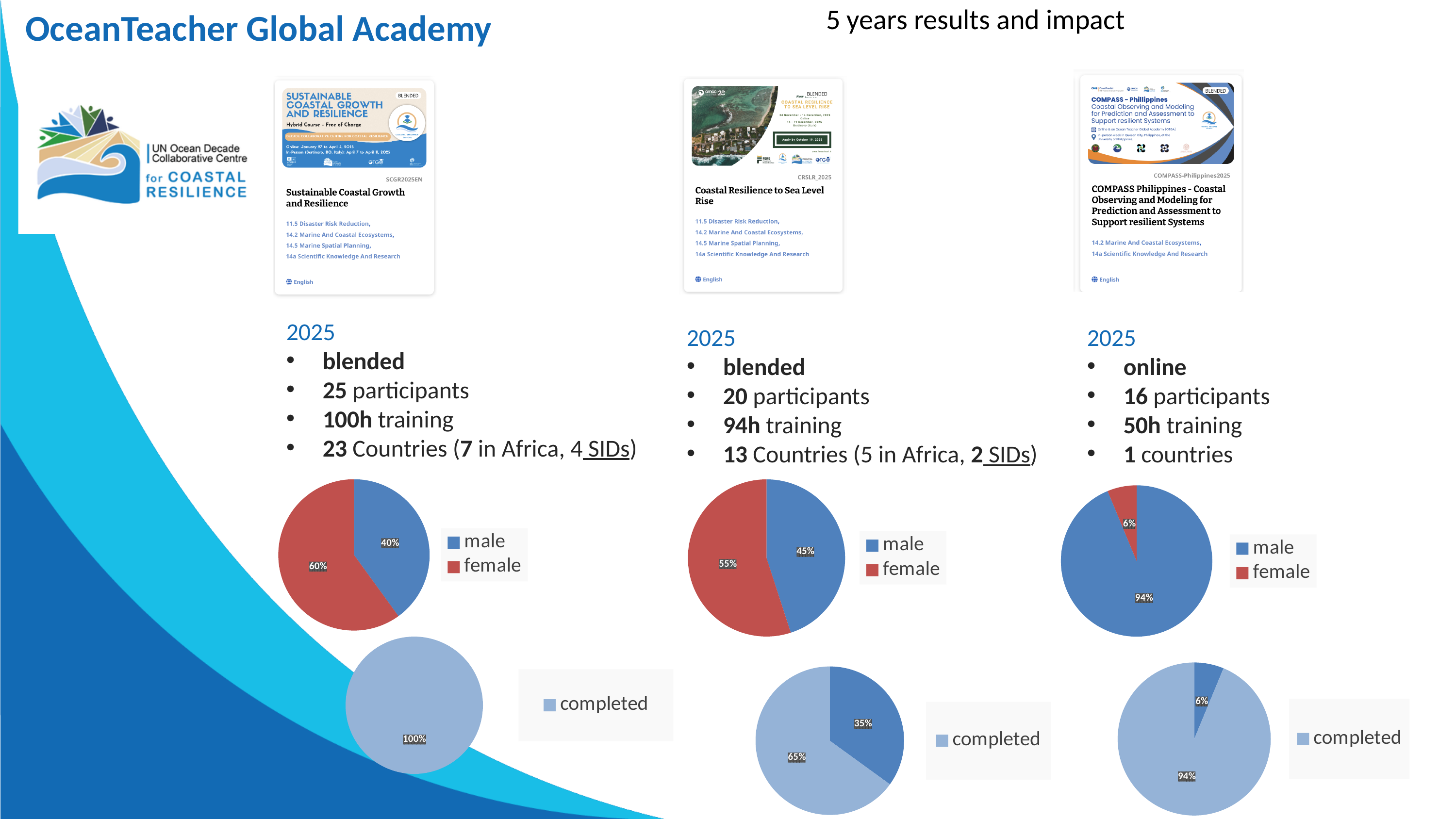
In the top-middle pie chart (male/female), what is the difference between the female and male shares? 10% In the top-right pie chart (male/female), what share is male? 94% In the top-left pie chart (male/female), what share is male? 40% In the top-right pie chart (male/female), which slice is the largest? male In the top-left pie chart (male/female), which slice is larger, male or female? female In the top-left pie chart (male/female), what share is female? 60% In the top-middle pie chart (male/female), what share is male? 45% In the top-right pie chart (male/female), what share is female? 6% In the top-middle pie chart (male/female), what share is female? 55% In the bottom-left pie chart, what percentage is shown on the single slice? 100% What type of chart is the bottom-left chart labelled 'completed'? pie chart How many entries does the legend of the top-middle pie chart list? 2